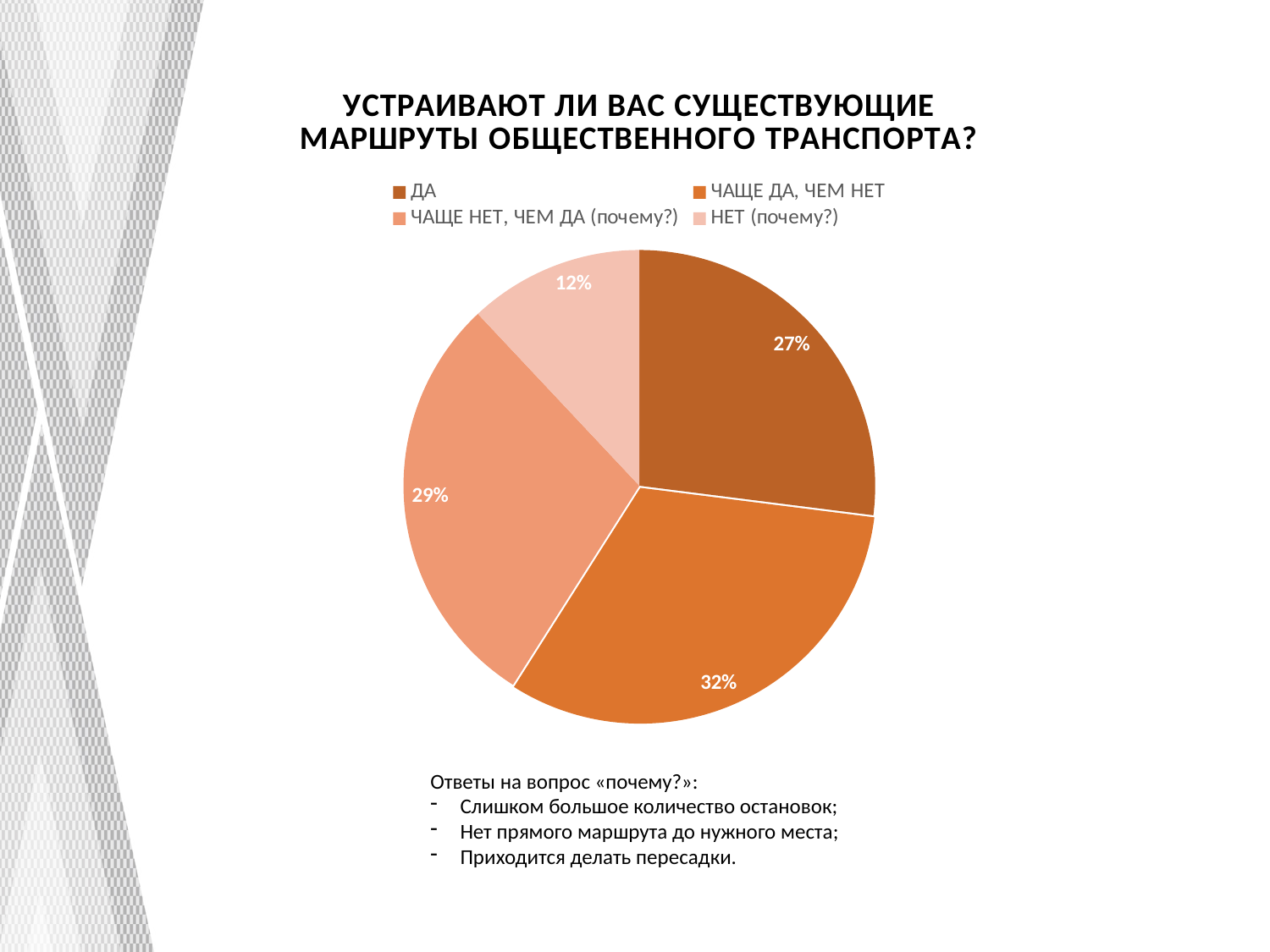
What percentage of respondents answered "ЧАЩЕ ДА, ЧЕМ НЕТ"? 32% What percentage of respondents answered "ЧАЩЕ НЕТ, ЧЕМ ДА (почему?)"? 29% How many entries does the legend list? 4 Which answer has the largest share of the pie? ЧАЩЕ ДА, ЧЕМ НЕТ What percentage of respondents answered "НЕТ (почему?)"? 12% What percentage of respondents answered "ДА"? 27% How many slices does the pie chart have? 4 What is the title of the chart? УСТРАИВАЮТ ЛИ ВАС СУЩЕСТВУЮЩИЕ МАРШРУТЫ ОБЩЕСТВЕННОГО ТРАНСПОРТА? What type of chart is shown on the slide? pie chart Which answer has the smallest share of the pie? НЕТ (почему?) Which is larger: the share for "ДА" or the share for "ЧАЩЕ НЕТ, ЧЕМ ДА (почему?)"? ЧАЩЕ НЕТ, ЧЕМ ДА (почему?) What is the difference in percentage points between "ЧАЩЕ ДА, ЧЕМ НЕТ" and "НЕТ (почему?)"? 20